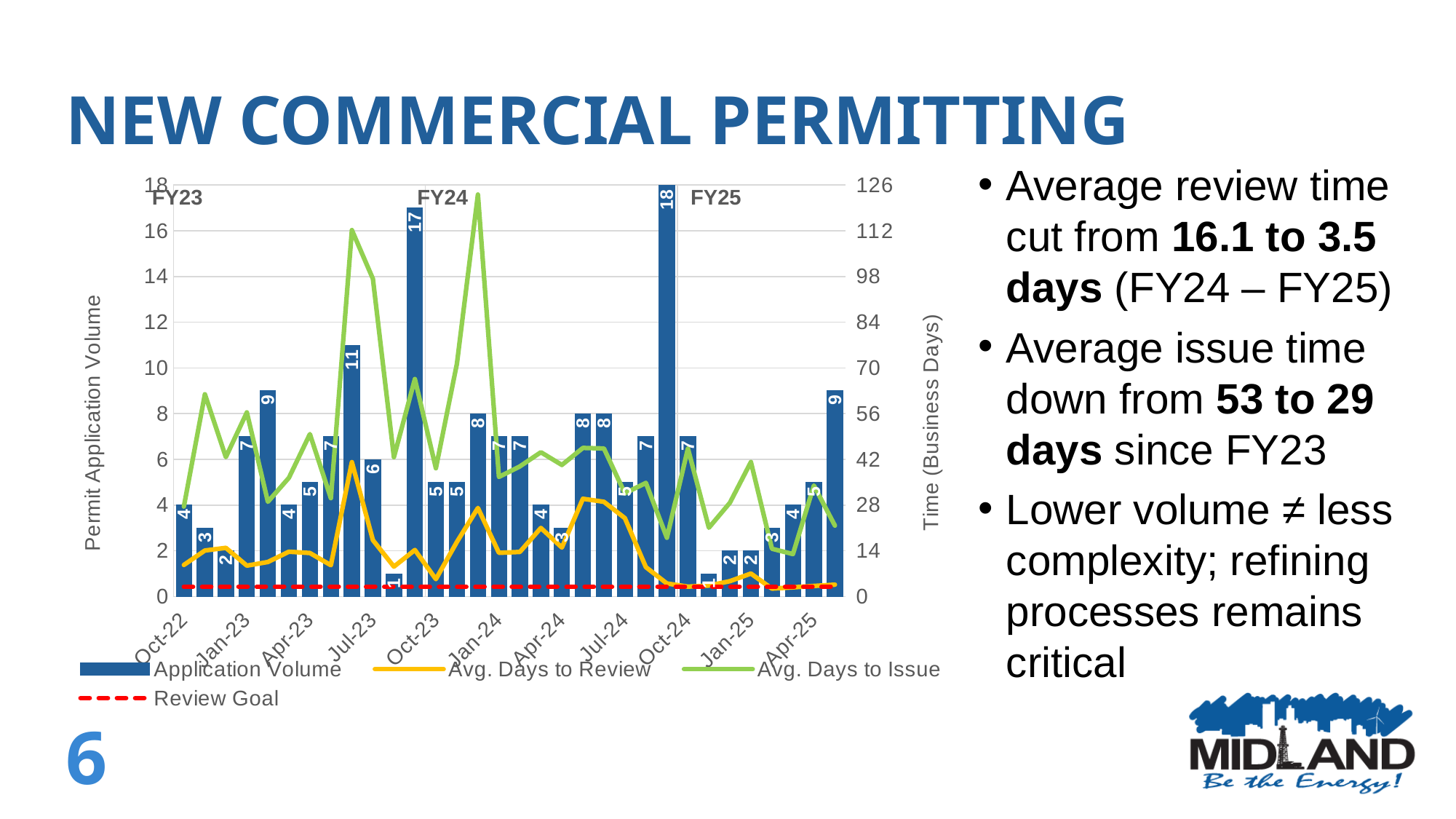
Which has the larger Application Volume, Oct-22 or Jan-23? Jan-23 What is the highest Application Volume value shown on the chart? 18 Is the peak value of the Avg. Days to Issue line greater or less than 98 business days? greater Is the Review Goal line greater or less than 14 business days? less How many series does the chart legend list? 4 What is the Application Volume for Jan-25? 2 What is the Application Volume for Apr-24? 3 What is the difference between the two highest Application Volume bars (18 and 17)? 1 What is the title of the right-hand vertical axis? Time (Business Days) What is the Application Volume for Jan-23? 7 What is the Application Volume for Oct-22? 4 What kind of chart is shown on the slide? Combined bar and line chart